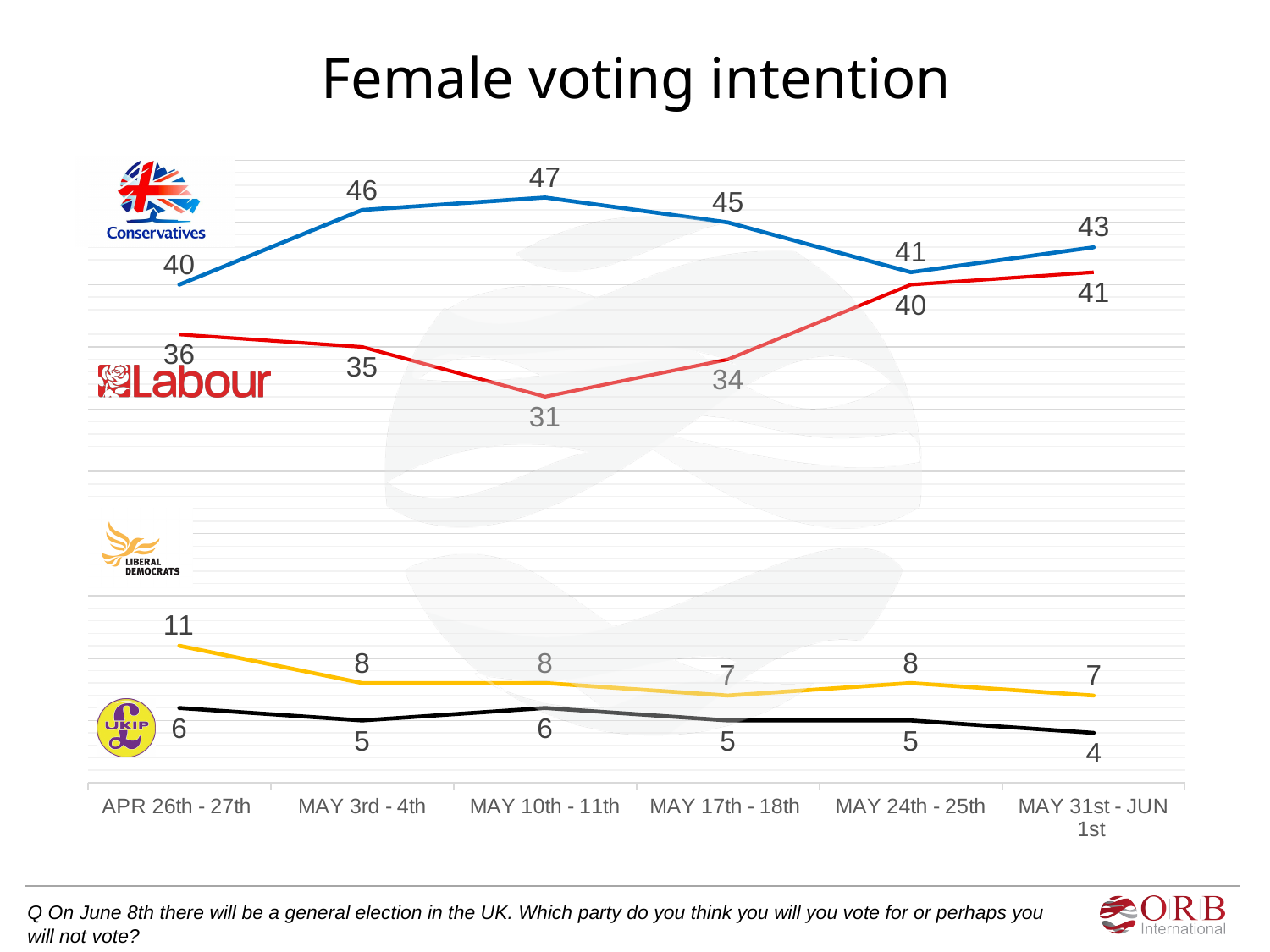
Which is larger for MAY 31st - JUN 1st, the Conservatives value or the Labour value? Conservatives What is the UKIP value for MAY 31st - JUN 1st? 4 How many time periods are shown on the x axis? 6 What kind of chart is shown on the slide? Line chart What is the Liberal Democrats value for MAY 24th - 25th? 8 What is the difference between the Conservatives and Labour values for MAY 10th - 11th? 16 In which period is the Conservatives line at its highest? MAY 10th - 11th What is the Labour value for APR 26th - 27th? 36 Does the Labour line rise or fall from MAY 10th - 11th to MAY 31st - JUN 1st? Rise How many parties (series) are plotted on the chart? 4 In which period is the Labour line at its lowest? MAY 10th - 11th What is the Conservatives value for MAY 10th - 11th? 47